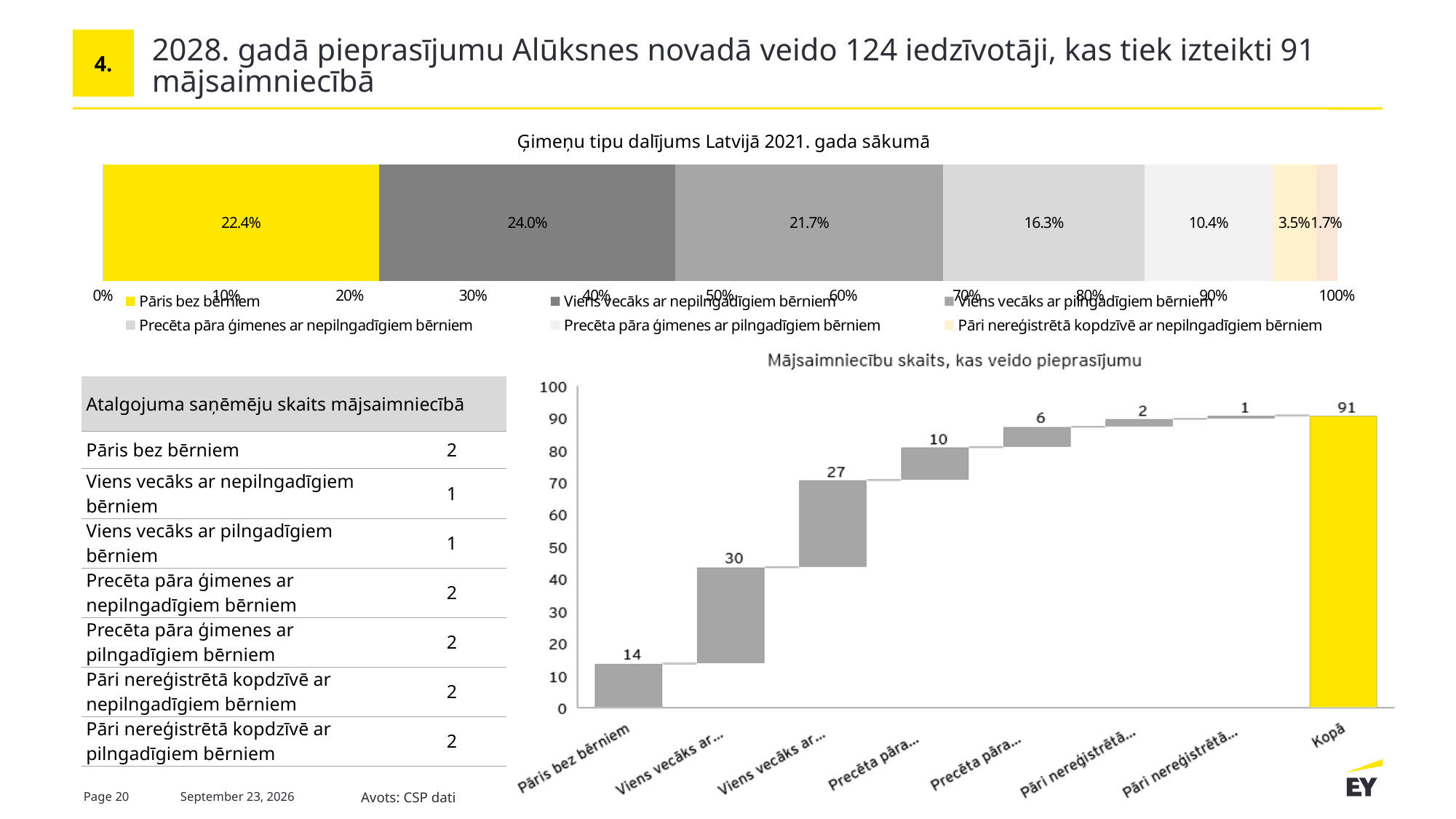
In the chart 'Mājsaimniecību skaits, kas veido pieprasījumu', is the value for 'Kopā' greater or less than 90? greater In the chart 'Mājsaimniecību skaits, kas veido pieprasījumu', what is the value for 'Kopā'? 91 In the chart 'Ģimeņu tipu dalījums Latvijā 2021. gada sākumā', what is the difference between the shares for 'Viens vecāks ar nepilngadīgiem bērniem' and 'Precēta pāra ģimenes ar pilngadīgiem bērniem'? 13.6% In the chart 'Mājsaimniecību skaits, kas veido pieprasījumu', how many categories are shown on the x axis? 8 In the chart 'Mājsaimniecību skaits, kas veido pieprasījumu', what is the value of the second bar from the left? 30 In the chart 'Ģimeņu tipu dalījums Latvijā 2021. gada sākumā', what share is shown for 'Pāris bez bērniem'? 22.4% In the chart 'Ģimeņu tipu dalījums Latvijā 2021. gada sākumā', how many entries does the legend list? 6 In the chart 'Mājsaimniecību skaits, kas veido pieprasījumu', what is the value for 'Pāris bez bērniem'? 14 What kind of chart is 'Ģimeņu tipu dalījums Latvijā 2021. gada sākumā'? Stacked bar chart In the chart 'Ģimeņu tipu dalījums Latvijā 2021. gada sākumā', which family type has the largest share? Viens vecāks ar nepilngadīgiem bērniem In the chart 'Ģimeņu tipu dalījums Latvijā 2021. gada sākumā', what share is shown for 'Viens vecāks ar nepilngadīgiem bērniem'? 24.0% In the chart 'Ģimeņu tipu dalījums Latvijā 2021. gada sākumā', which colour is used for 'Pāris bez bērniem'? Yellow